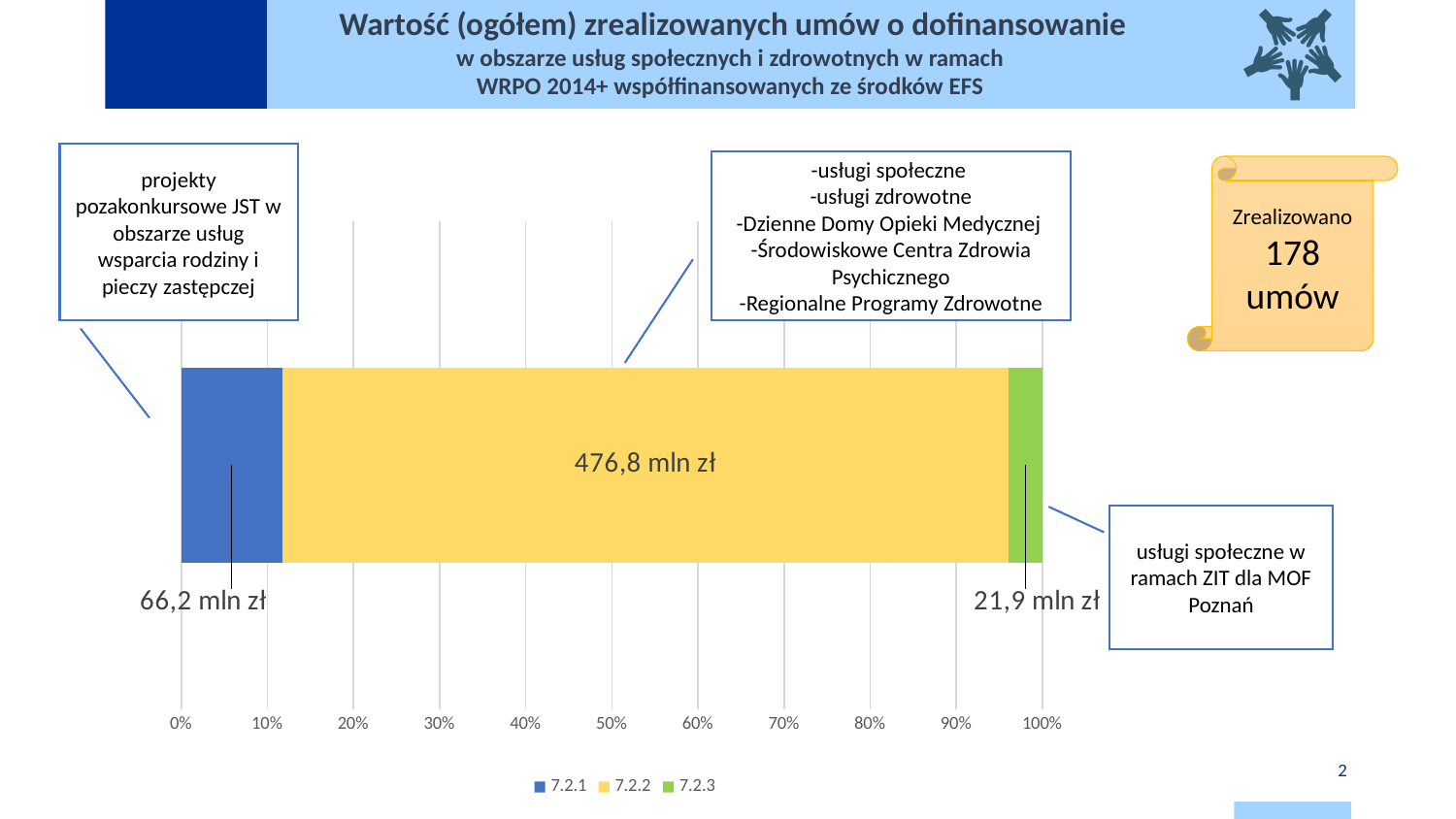
Which series has the highest value? 7.2.2 What is the value shown for series 7.2.1? 66,2 mln zł How many series does the legend list? 3 What kind of chart is shown on the slide? stacked bar chart Which series has the lowest value? 7.2.3 What colour is used for series 7.2.2 in the chart? yellow What is the difference between the values for 7.2.2 and 7.2.1? 410,6 mln zł What is the total of the three segments in the stacked bar? 565,0 mln zł What is the value shown for series 7.2.3? 21,9 mln zł Is the share of the bar taken by series 7.2.1 greater or less than 20%? less Which is larger, the value for 7.2.1 or the value for 7.2.3? 7.2.1 What is the value shown for series 7.2.2? 476,8 mln zł